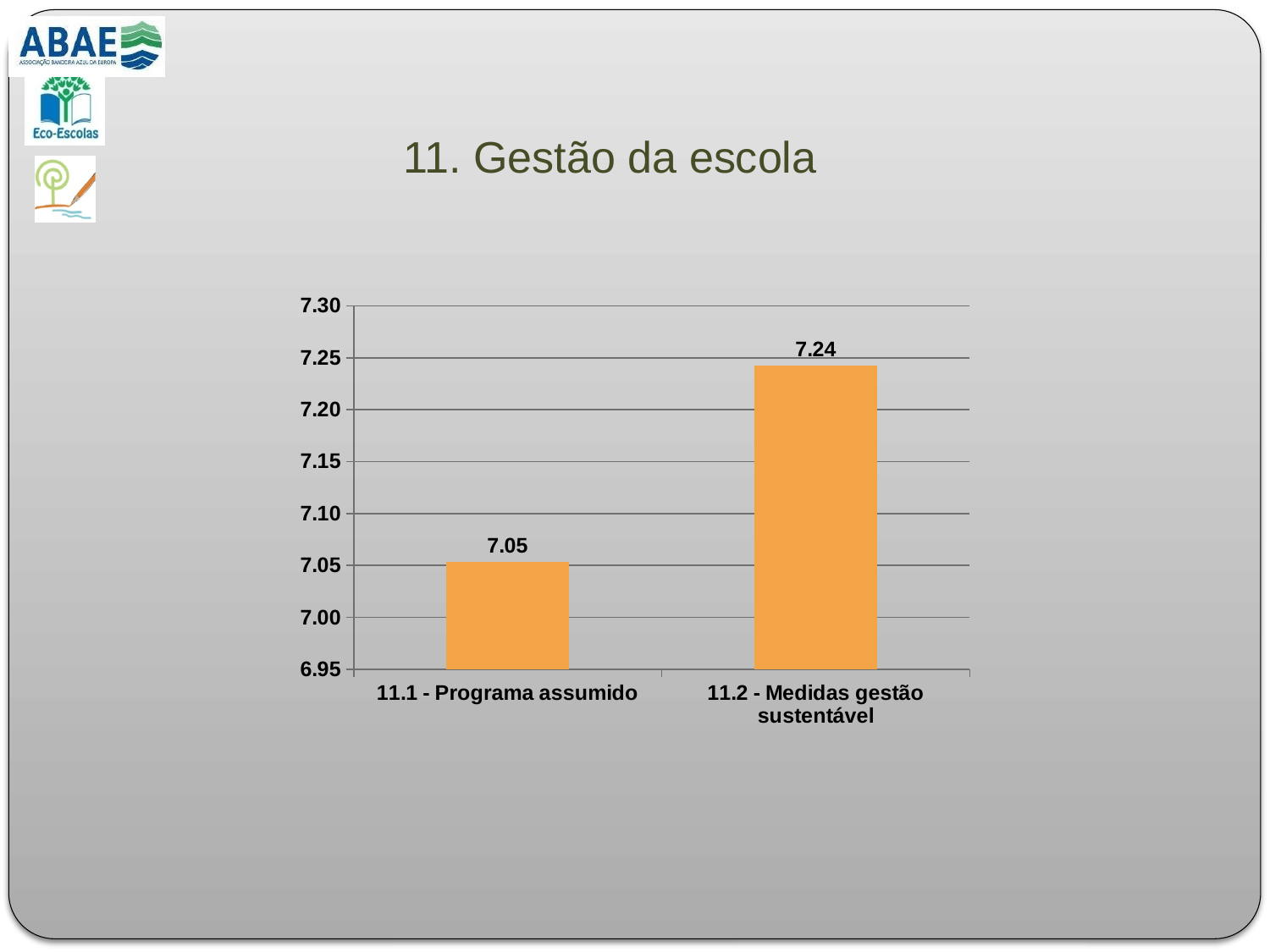
Is the value for 11.2 - Medidas gestão sustentável greater or less than 7.20? greater What is the value for 11.2 - Medidas gestão sustentável? 7.24 Which category has the lowest value? 11.1 - Programa assumido What is the title of the slide containing the chart? 11. Gestão da escola What is the difference between the values for 11.2 - Medidas gestão sustentável and 11.1 - Programa assumido? 0.19 Do the values rise or fall from left to right along the x axis? rise Which category has the highest value? 11.2 - Medidas gestão sustentável Which is larger, the value for 11.1 - Programa assumido or the value for 11.2 - Medidas gestão sustentável? 11.2 - Medidas gestão sustentável What kind of chart is shown on the slide? bar chart Is the value for 11.1 - Programa assumido greater or less than 7.10? less How many categories are shown in the chart? 2 What is the value for 11.1 - Programa assumido? 7.05